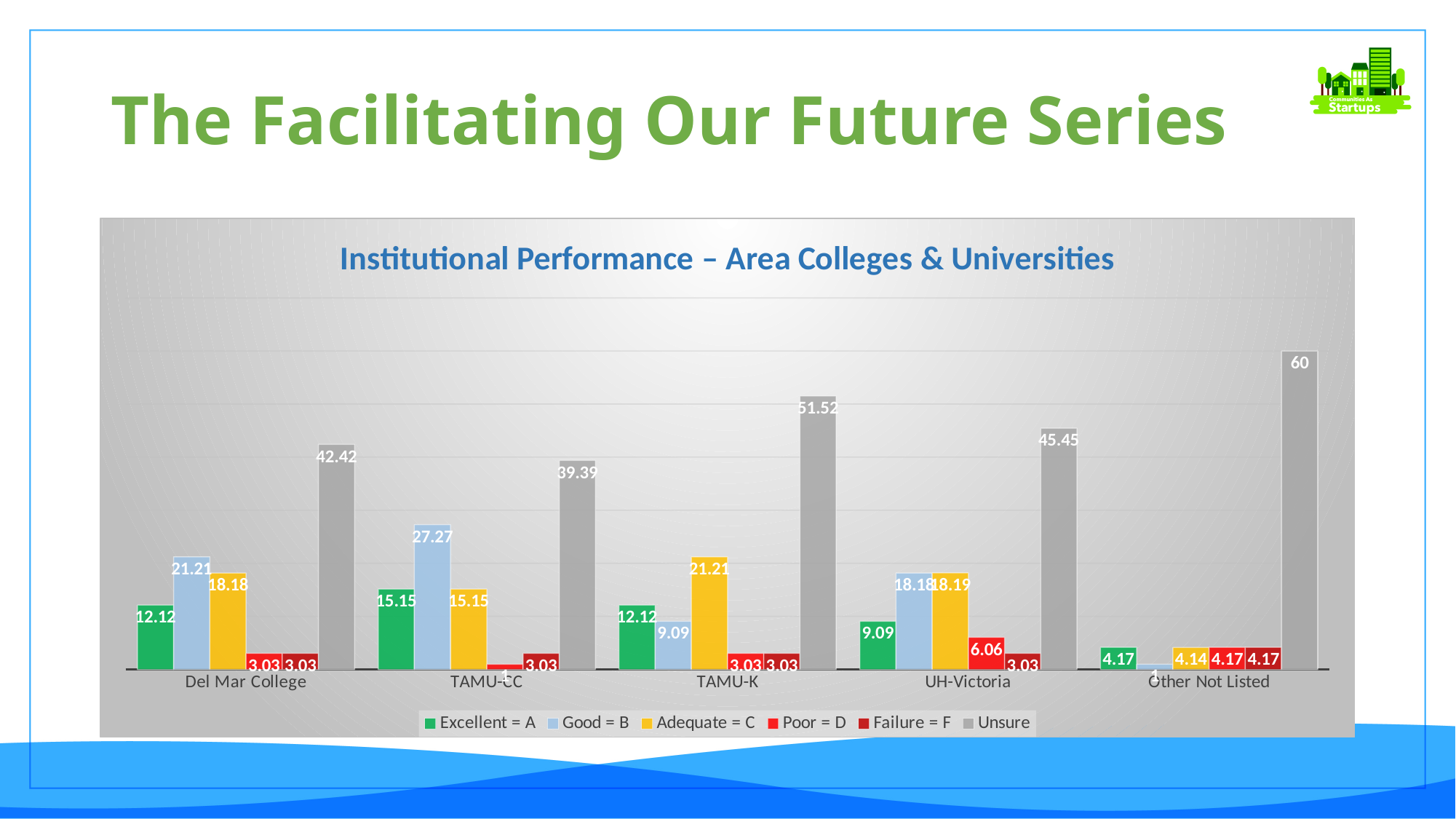
How many series does the legend list? 6 What is the Good = B value for TAMU-CC? 27.27 How many categories are shown on the x axis? 5 What kind of chart is shown on the slide? Bar chart Which category has the highest Unsure value? Other Not Listed What is the difference between the Unsure values for TAMU-K and Del Mar College? 9.10 What is the Adequate = C value for TAMU-K? 21.21 What is the Unsure value for Other Not Listed? 60 Which category has the lowest Excellent = A value? Other Not Listed What is the title of the chart? Institutional Performance – Area Colleges & Universities What is the Poor = D value for UH-Victoria? 6.06 Which is larger, the Good = B value for Del Mar College or the Good = B value for TAMU-K? Del Mar College